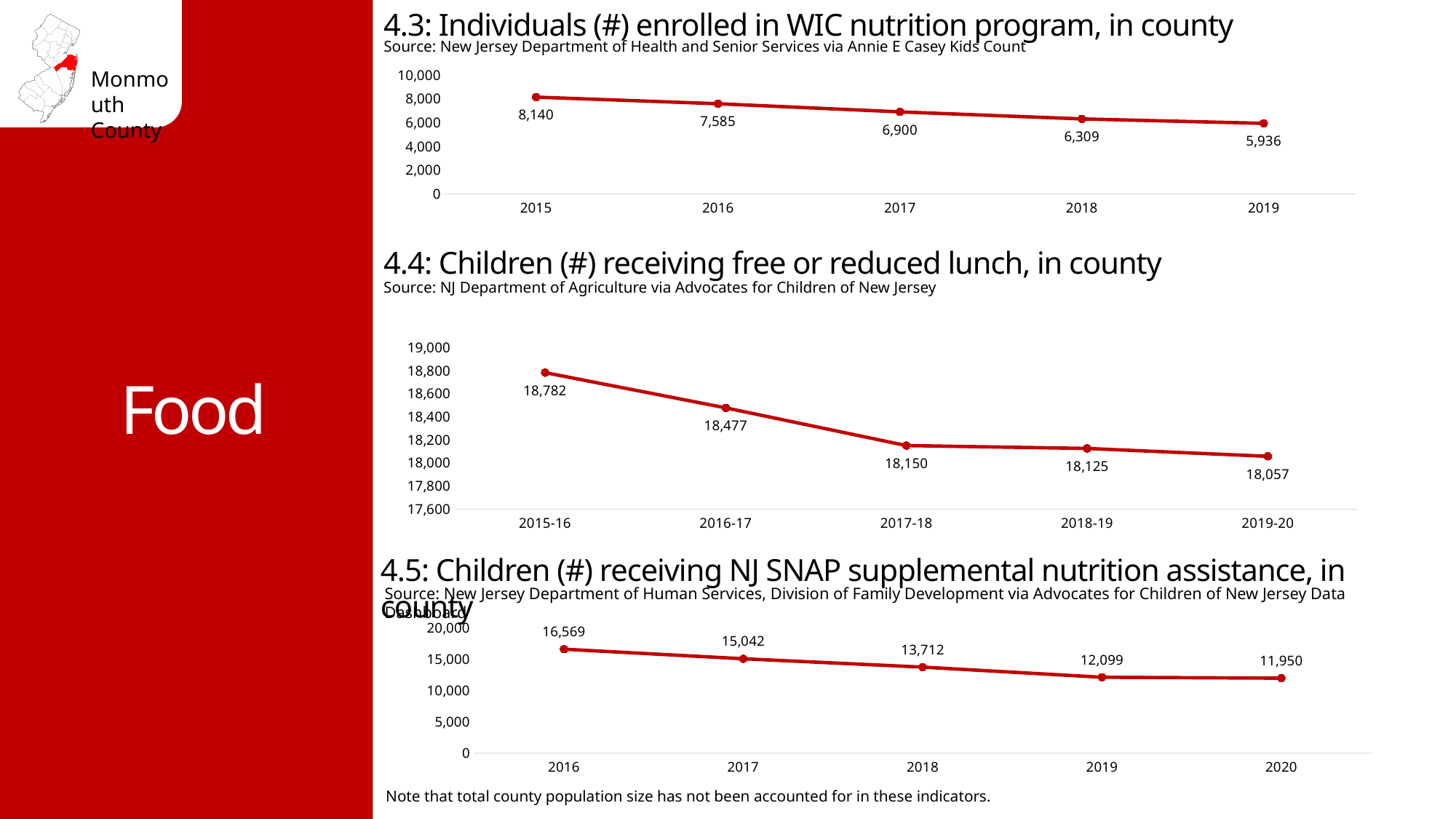
In the chart '4.4: Children (#) receiving free or reduced lunch, in county', how many data points are plotted? 5 In the chart '4.5: Children (#) receiving NJ SNAP supplemental nutrition assistance, in county', which is larger, the value for 2019 or the value for 2020? 2019 In the chart '4.5: Children (#) receiving NJ SNAP supplemental nutrition assistance, in county', what is the value for 2018? 13,712 In the chart '4.3: Individuals (#) enrolled in WIC nutrition program, in county', what is the difference between the 2015 and 2019 values? 2,204 In the chart '4.3: Individuals (#) enrolled in WIC nutrition program, in county', what is the value for 2017? 6,900 In the chart '4.5: Children (#) receiving NJ SNAP supplemental nutrition assistance, in county', what is the difference between the 2016 and 2017 values? 1,527 In the chart '4.4: Children (#) receiving free or reduced lunch, in county', what is the value for 2016-17? 18,477 In the chart '4.3: Individuals (#) enrolled in WIC nutrition program, in county', which year has the highest value? 2015 In the chart '4.3: Individuals (#) enrolled in WIC nutrition program, in county', do the values rise or fall from 2015 to 2019? fall In the chart '4.4: Children (#) receiving free or reduced lunch, in county', what is the difference between the 2015-16 and 2016-17 values? 305 What kind of chart is '4.5: Children (#) receiving NJ SNAP supplemental nutrition assistance, in county'? line chart In the chart '4.4: Children (#) receiving free or reduced lunch, in county', which school year has the lowest value? 2019-20